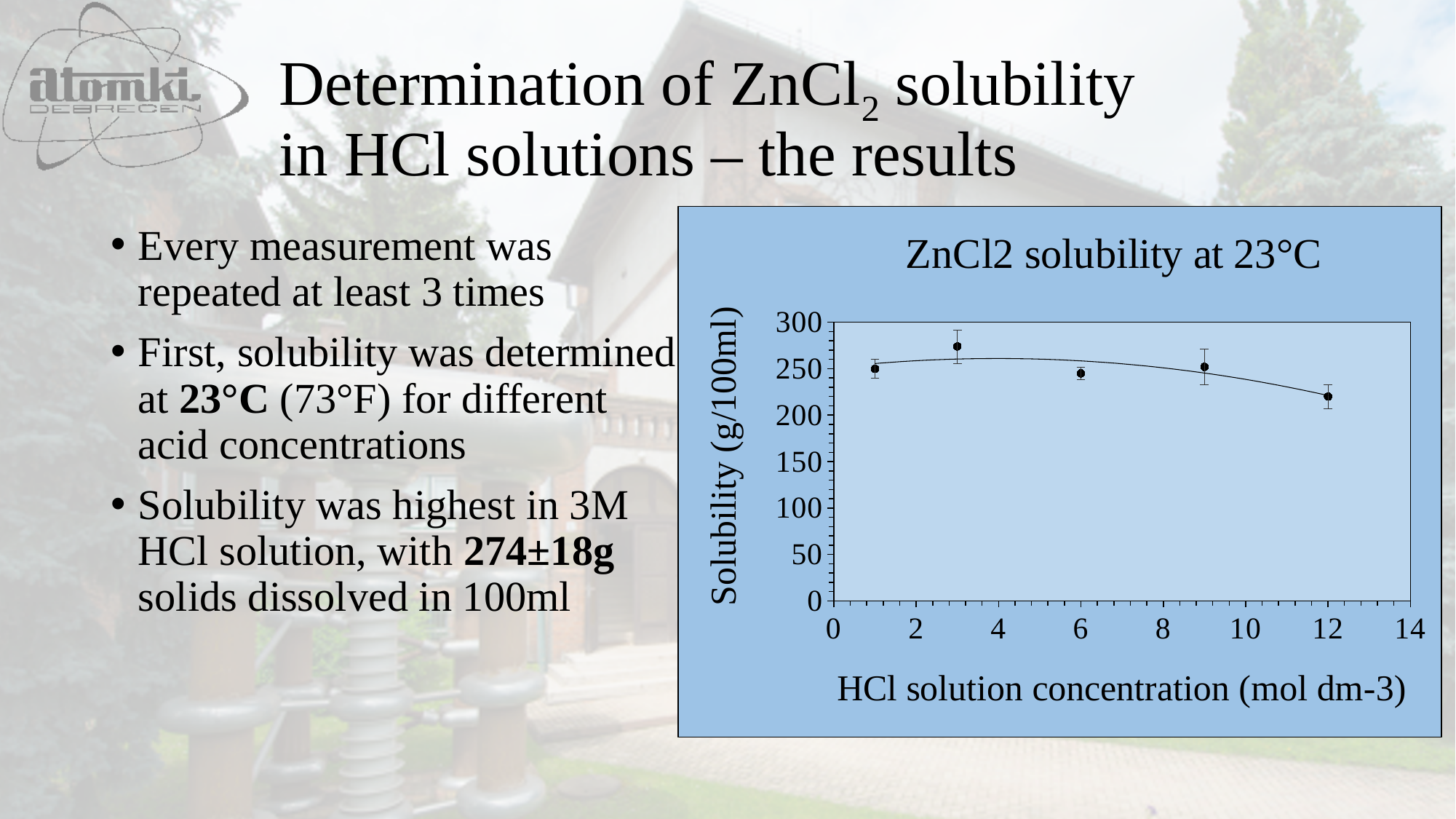
Which has the higher solubility: HCl concentration 1 or HCl concentration 12? 1 Which has the higher solubility: HCl concentration 3 or HCl concentration 12? 3 What kind of chart is shown on the slide? Scatter chart with error bars and a trend line At which HCl concentration is the solubility lowest? 12 Is the solubility at an HCl concentration of 1 greater or less than 200? greater What is the title of the chart? ZnCl2 solubility at 23°C What is the label of the y axis of the chart? Solubility (g/100ml) Is the solubility at an HCl concentration of 3 greater or less than 250? greater At which HCl concentration is the solubility highest? 3 Does the solubility rise or fall as the HCl concentration increases from 3 to 12? fall Is the solubility at an HCl concentration of 12 greater or less than 250? less How many data points are plotted in the chart? 5